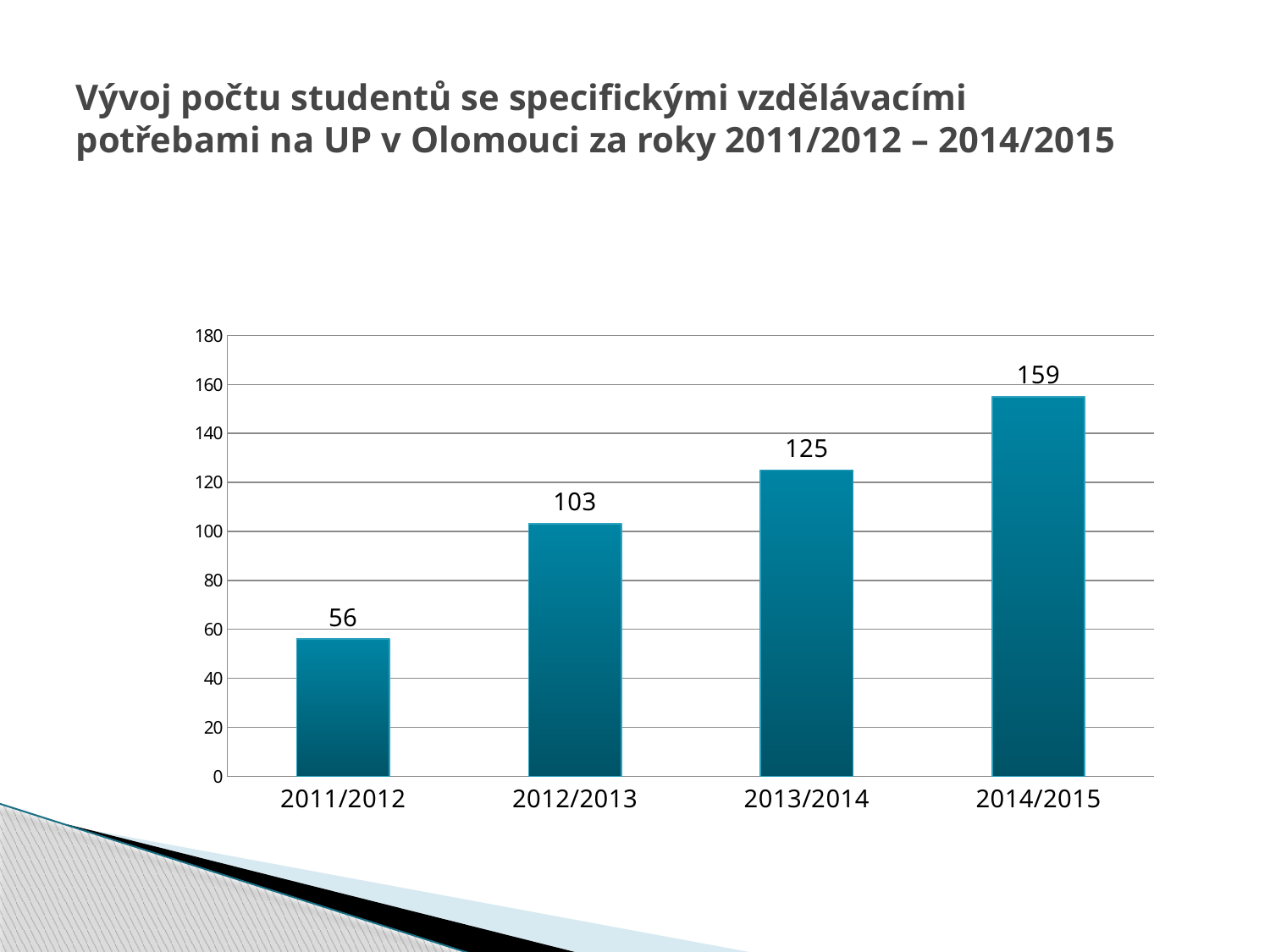
How many years are shown on the x axis? 4 Do the values rise or fall from 2011/2012 to 2014/2015? rise What is the value for 2011/2012? 56 Which year has the highest value? 2014/2015 What is the difference between the values for 2014/2015 and 2011/2012? 103 What is the value for 2014/2015? 159 What is the difference between the values for 2012/2013 and 2011/2012? 47 Which is larger, the value for 2012/2013 or the value for 2013/2014? 2013/2014 Is the value for 2013/2014 greater or less than 140? less What is the value for 2013/2014? 125 What is the value for 2012/2013? 103 Which year has the lowest value? 2011/2012